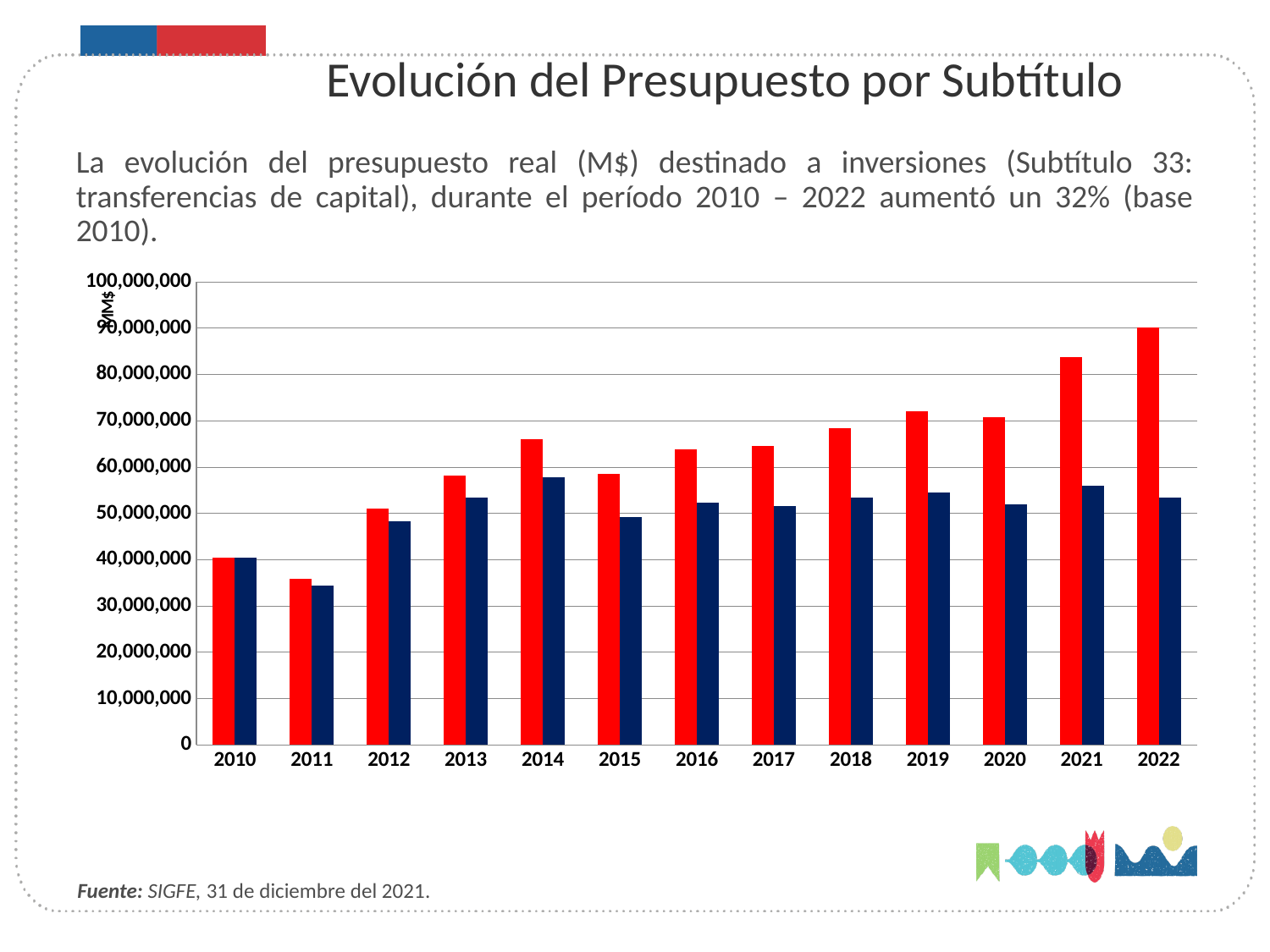
Is the value of the red bar for 2011 greater or less than 40,000,000? less Is the value of the dark blue bar for 2022 greater or less than 50,000,000? greater Is the value of the dark blue bar for 2014 greater or less than 60,000,000? less How many bars are plotted for each year in the chart? 2 Which year has the shortest dark blue bar in the chart? 2011 In 2022, which bar is taller, the red bar or the dark blue bar? the red bar How many years are shown on the x axis of the chart? 13 Which year has the shortest red bar in the chart? 2011 What kind of chart is shown on the slide? bar chart Which year has the tallest red bar in the chart? 2022 Which is larger, the red bar for 2014 or the red bar for 2015? 2014